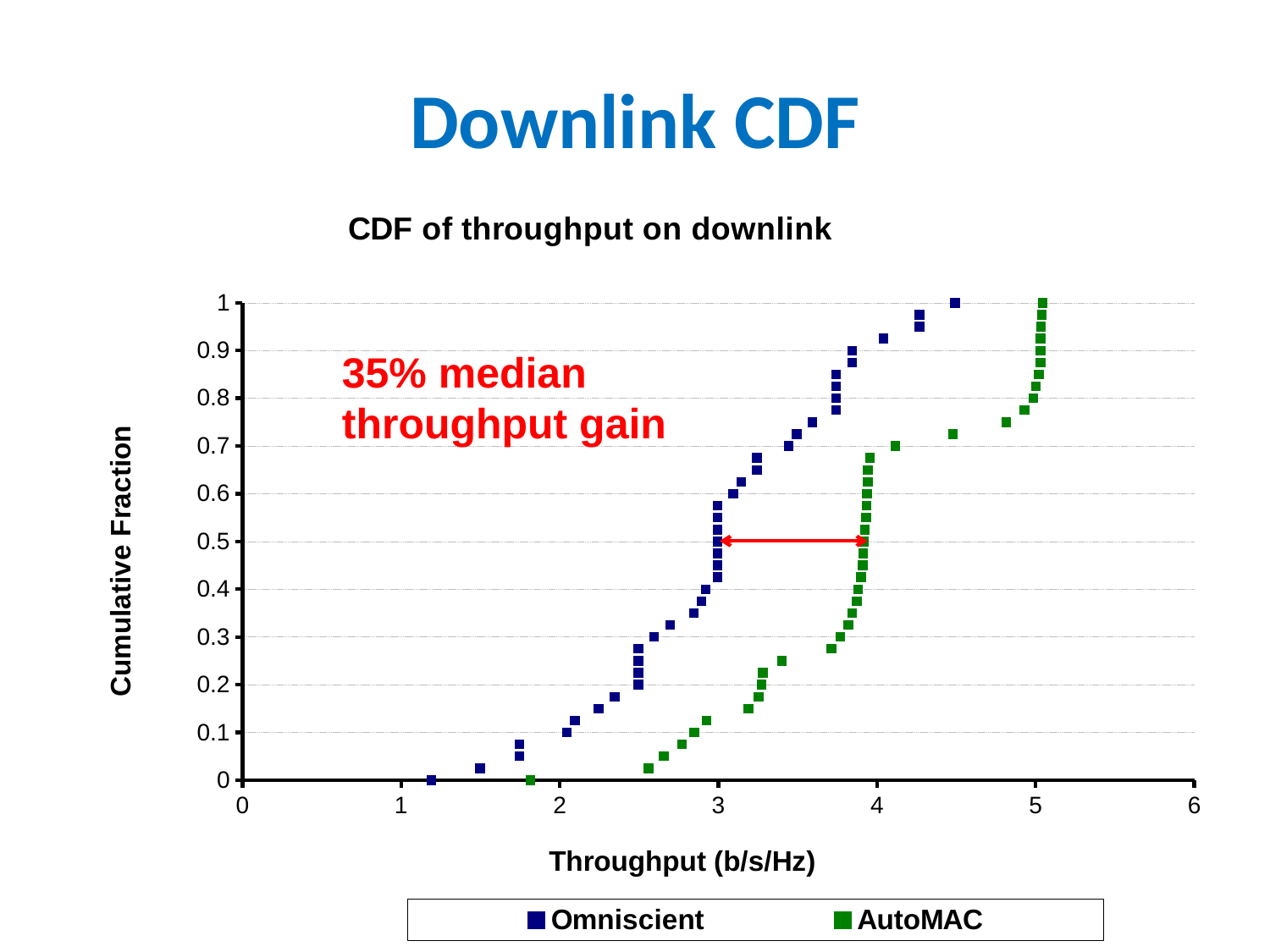
What kind of chart is shown on the slide? Scatter chart What median throughput gain does the annotation on the chart state? 35% Is the throughput of the AutoMAC series at a cumulative fraction of 0.5 greater or less than 3? greater Is the highest throughput value of the Omniscient series greater or less than 5? less Is the lowest throughput value of the AutoMAC series greater or less than 2? less Which series reaches a higher throughput at a cumulative fraction of 0.5, Omniscient or AutoMAC? AutoMAC What are the two series named in the legend? Omniscient and AutoMAC How many series does the legend list? 2 Which series reaches a cumulative fraction of 1 at the higher throughput, Omniscient or AutoMAC? AutoMAC What is the title of the chart? CDF of throughput on downlink Does the cumulative fraction rise or fall as throughput increases along the x axis? Rise